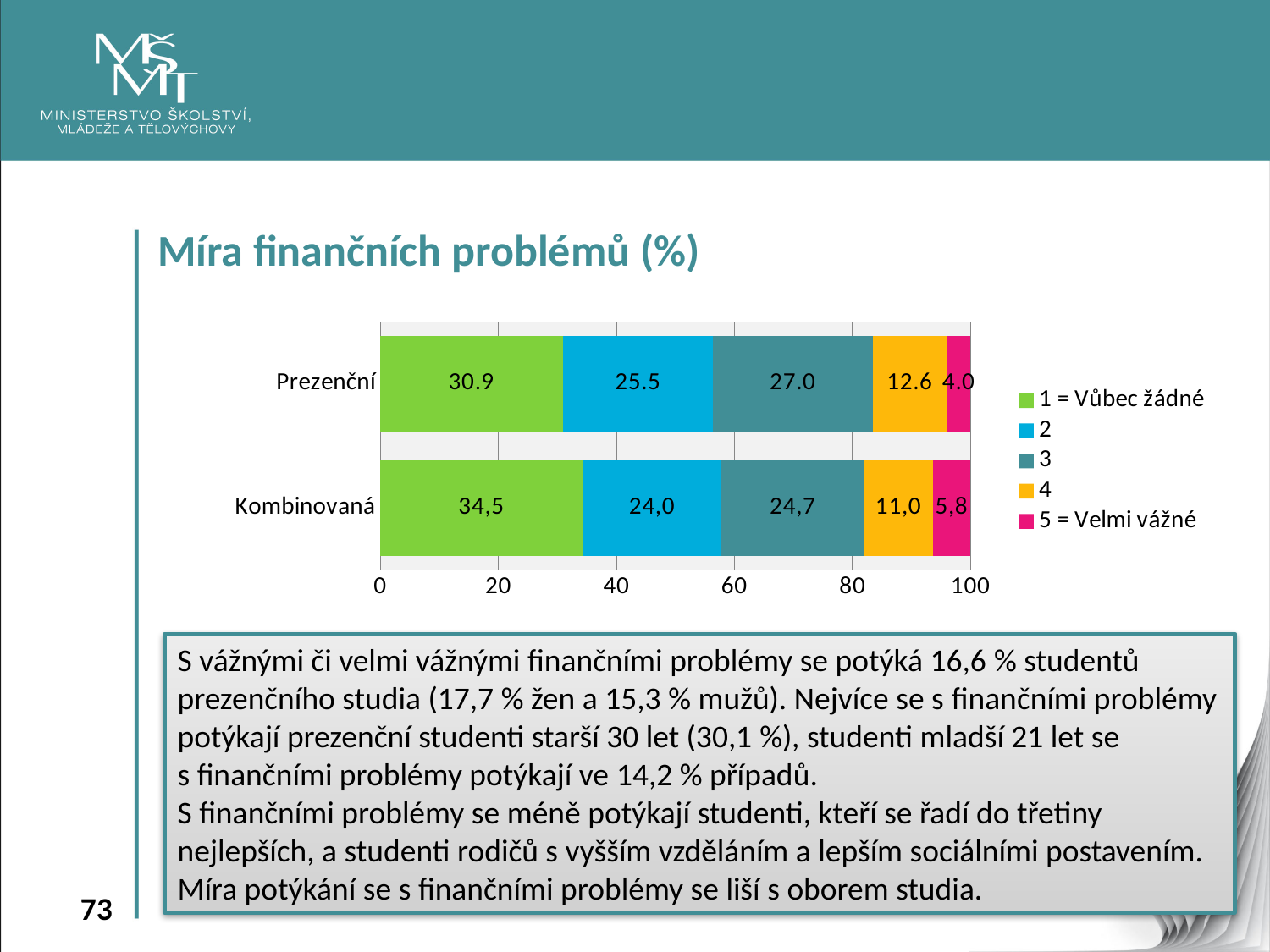
Which segment of the Prezenční bar has the smallest value? 5 = Velmi vážné What value is shown for the '1 = Vůbec žádné' segment of the Kombinovaná bar? 34,5 Which segment of the Kombinovaná bar has the largest value? 1 = Vůbec žádné What value is shown for series 3 in the Prezenční bar? 27.0 What type of chart is shown on the slide? Stacked bar chart What value is shown for series 4 in the Kombinovaná bar? 11,0 How many series does the legend list? 5 What value is shown for the '5 = Velmi vážné' segment of the Kombinovaná bar? 5,8 How many categories (bars) are shown on the chart? 2 Which is larger: the '1 = Vůbec žádné' value for Prezenční or for Kombinovaná? Kombinovaná What value is shown for the '1 = Vůbec žádné' segment of the Prezenční bar? 30.9 What is the difference between the series 2 value for Prezenční (25.5) and for Kombinovaná (24,0)? 1.5